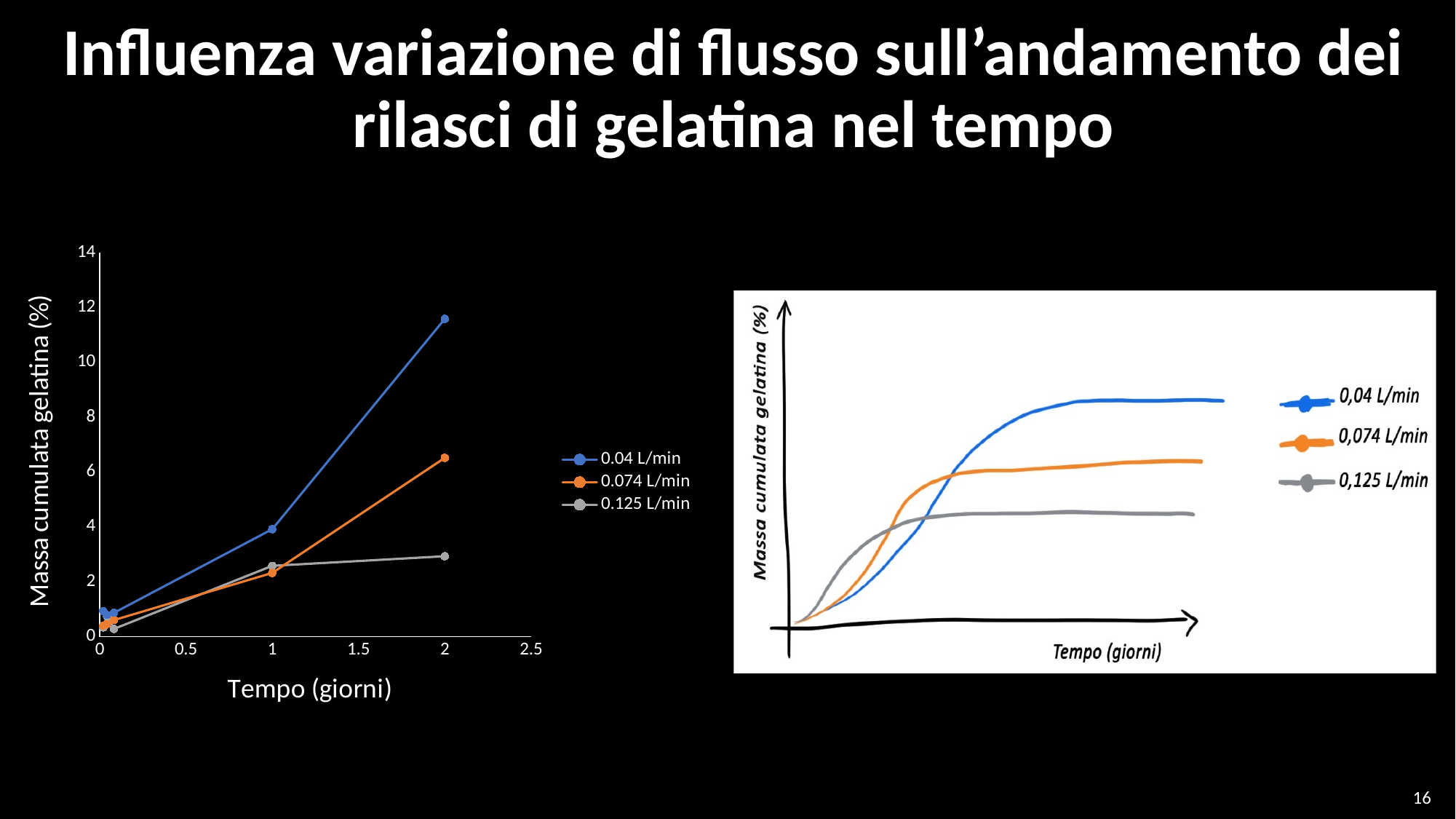
In the chart on the right of the slide, which series reaches the lowest plateau? 0,125 L/min In the left chart, does the 0.04 L/min series rise or fall as time increases? rise In the chart on the right of the slide, which series reaches the highest plateau? 0,04 L/min In the left chart, which series has the lowest value at 2 days? 0.125 L/min In the left chart, is the value for 0.074 L/min at 2 days greater or less than 8? less In the left chart, which is larger at 2 days: the value for 0.04 L/min or the value for 0.074 L/min? 0.04 L/min In the left chart, is the value for 0.125 L/min at 2 days greater or less than 4? less In the left chart, which series has the highest value at 2 days? 0.04 L/min How many series does the legend of the left chart list? 3 What kind of chart is the chart on the left of the slide? line chart What is the label of the y axis of the left chart? Massa cumulata gelatina (%) In the left chart, is the value for 0.04 L/min at 2 days greater or less than 10? greater